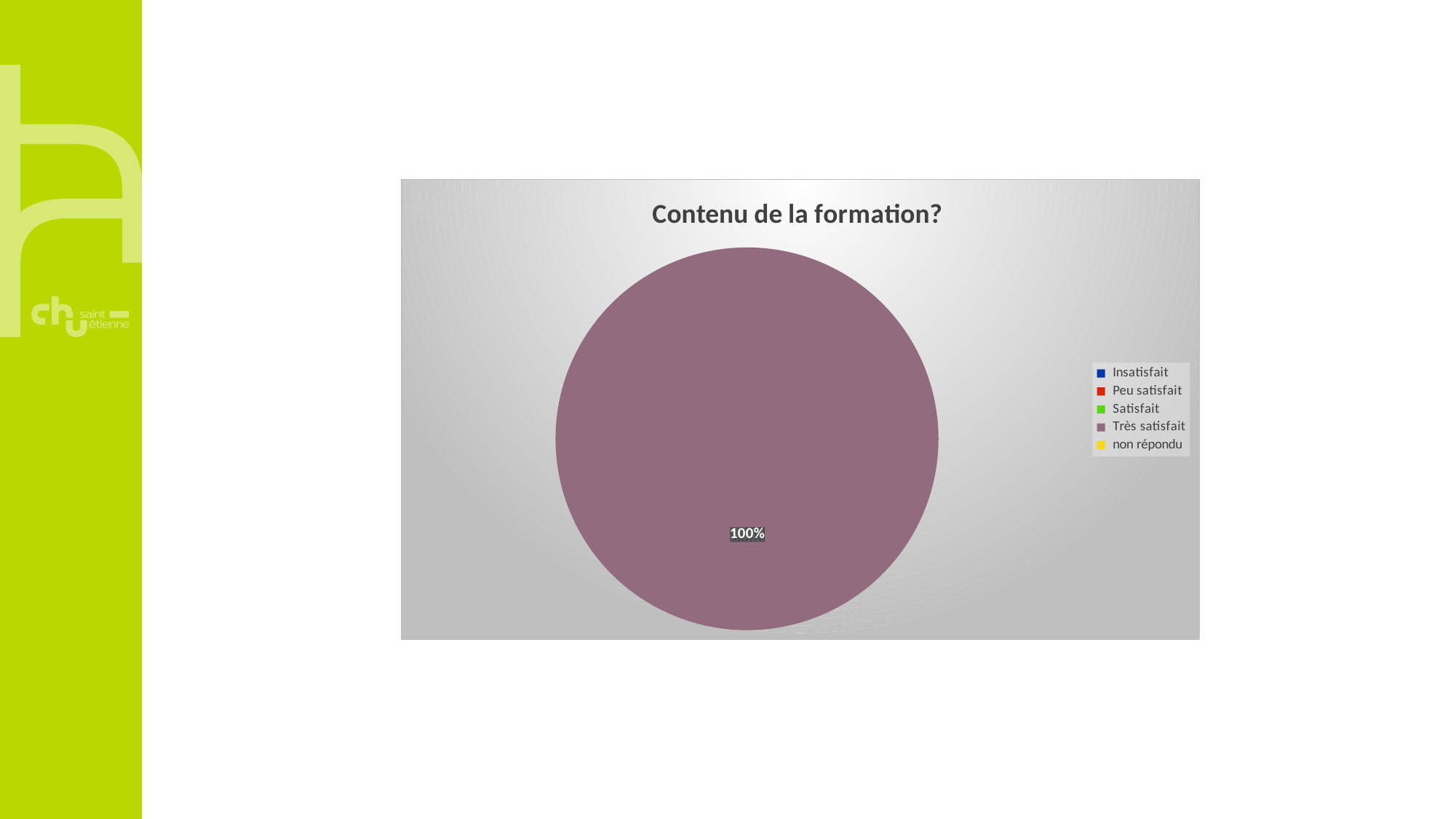
Which legend entry is shown in yellow? non répondu How many entries does the legend list? 5 What share of the pie does "Très satisfait" take? 100% Which is larger, the share for "Très satisfait" or the share for "Satisfait"? Très satisfait What is the title of the chart? Contenu de la formation? What is the data label printed on the pie? 100% What kind of chart is shown on the slide? pie chart Is the share for "Très satisfait" greater or less than 50%? greater Which category makes up the largest share of the pie? Très satisfait